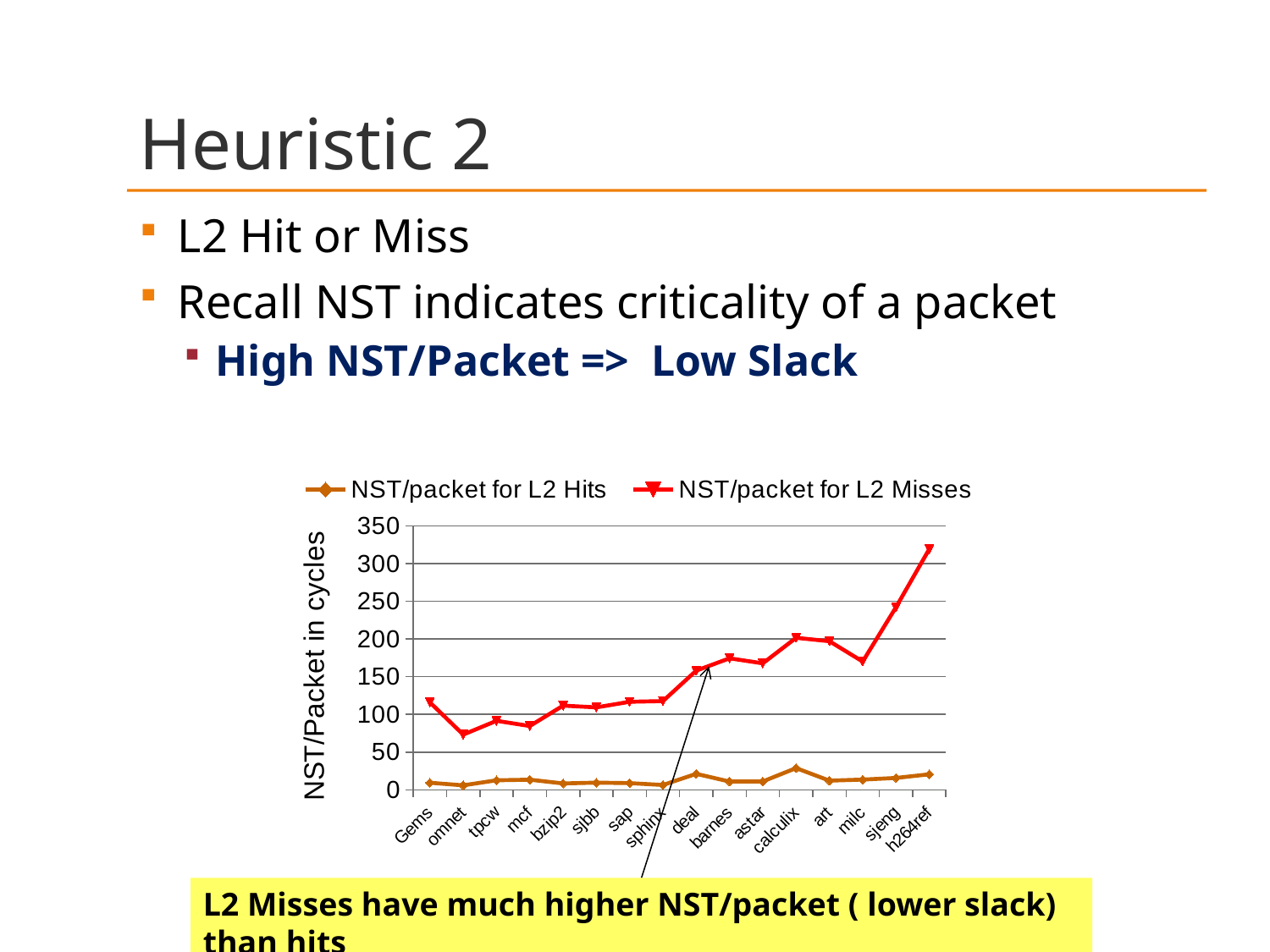
How many series does the legend list? 2 How many benchmarks (categories) are plotted along the x axis? 16 Does NST/packet for L2 Misses generally rise or fall from Gems to h264ref? rise For which benchmark is NST/packet for L2 Misses lowest? omnet Is the value of NST/packet for L2 Misses for omnet greater or less than 100? less Which series has the larger value for Gems, NST/packet for L2 Hits or NST/packet for L2 Misses? NST/packet for L2 Misses What is the label of the y axis? NST/Packet in cycles Is the value of NST/packet for L2 Hits for calculix greater or less than 50? less For which benchmark is NST/packet for L2 Misses highest? h264ref Is the value of NST/packet for L2 Misses for h264ref greater or less than 300? greater What kind of chart is shown on the slide? line chart